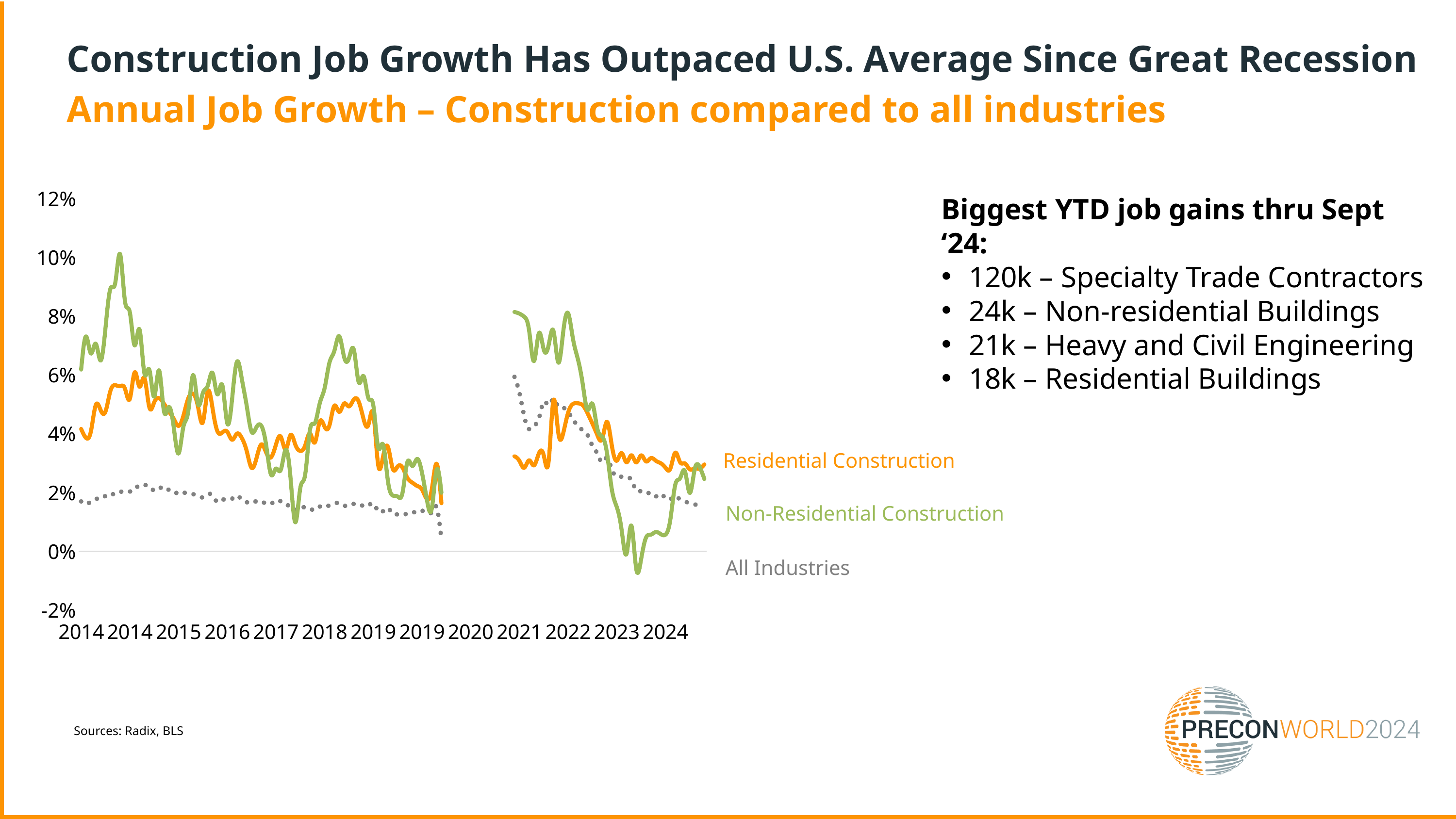
Is the All Industries value in 2015 greater or less than 4%? less Does the All Industries line rise or fall from 2021 to 2024? fall In 2023, which is higher: Residential Construction or Non-Residential Construction? Residential Construction How many series does the chart's legend list? 3 Is the peak value for Non-Residential Construction in 2014 greater or less than 8%? greater Which series reaches the highest value anywhere on the chart? Non-Residential Construction In 2014, which is higher: Non-Residential Construction or All Industries? Non-Residential Construction What kind of chart is shown on the slide? line chart Is the lowest value for Non-Residential Construction in 2023 greater or less than 0%? less What are the three series shown in the chart? Residential Construction, Non-Residential Construction, All Industries Which colour is used for the Residential Construction line? orange Which series dips to the lowest value on the chart, in 2023? Non-Residential Construction